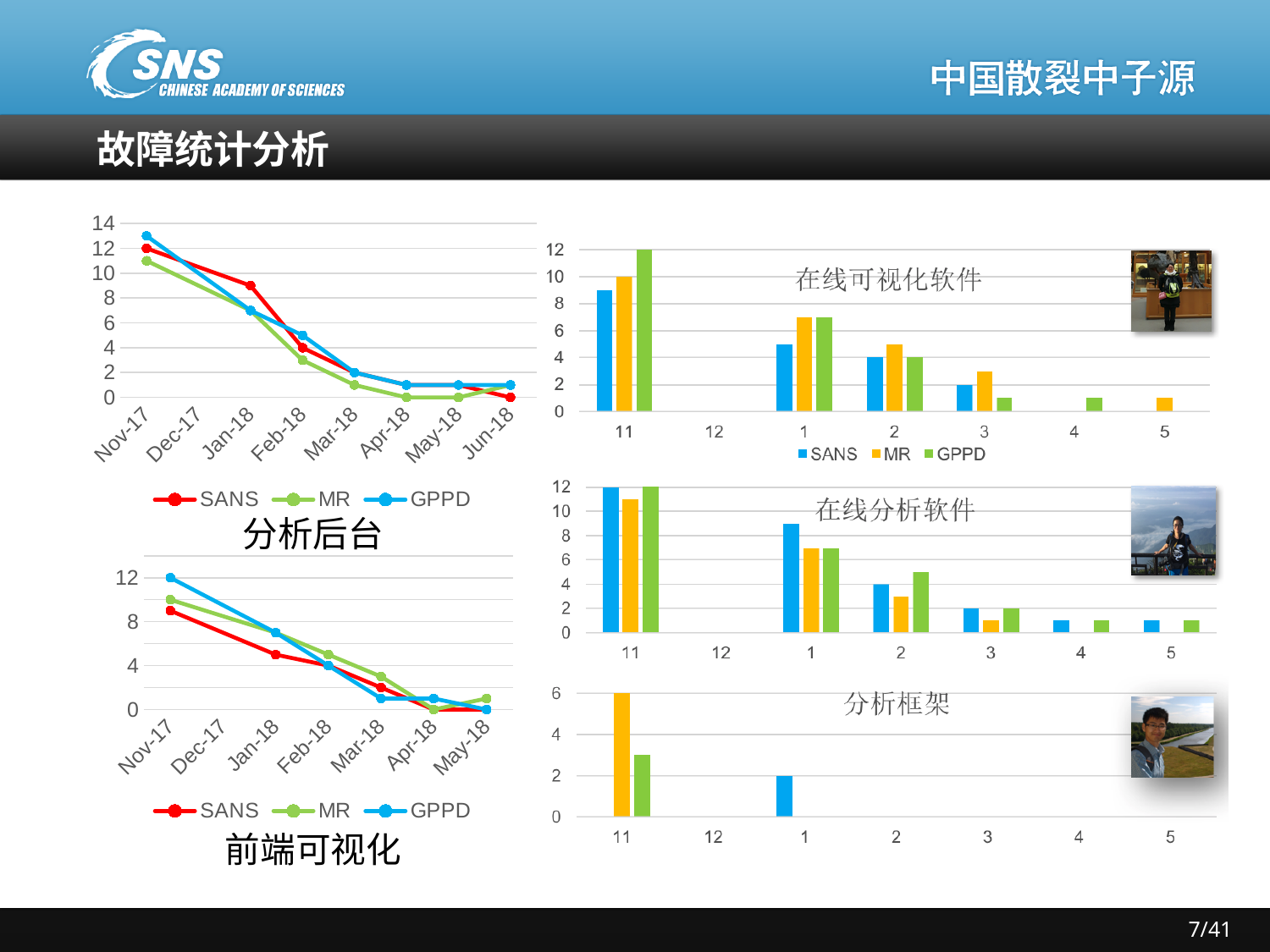
In the 分析后台 line chart, how many categories are shown on the x axis? 8 In the 在线可视化软件 bar chart, what is the value for GPPD at category 11? 12 In the 在线可视化软件 bar chart, what is the value for MR at category 11? 10 What kind of chart is the 分析后台 chart? line chart In the 分析框架 bar chart, what is the value for MR at category 11? 6 In the 在线分析软件 bar chart, is the value for SANS at category 1 greater or less than 8? greater In the 在线分析软件 bar chart, what is the value for SANS at category 11? 12 In the 在线可视化软件 bar chart, what is the value for SANS at category 2? 4 In the 分析框架 bar chart, what is the value for SANS at category 1? 2 In the 前端可视化 line chart, which series has the highest value at Nov-17? GPPD In the 在线可视化软件 bar chart, how many series does the legend list? 3 In the 分析框架 bar chart, is the value for GPPD at category 11 greater or less than 2? greater